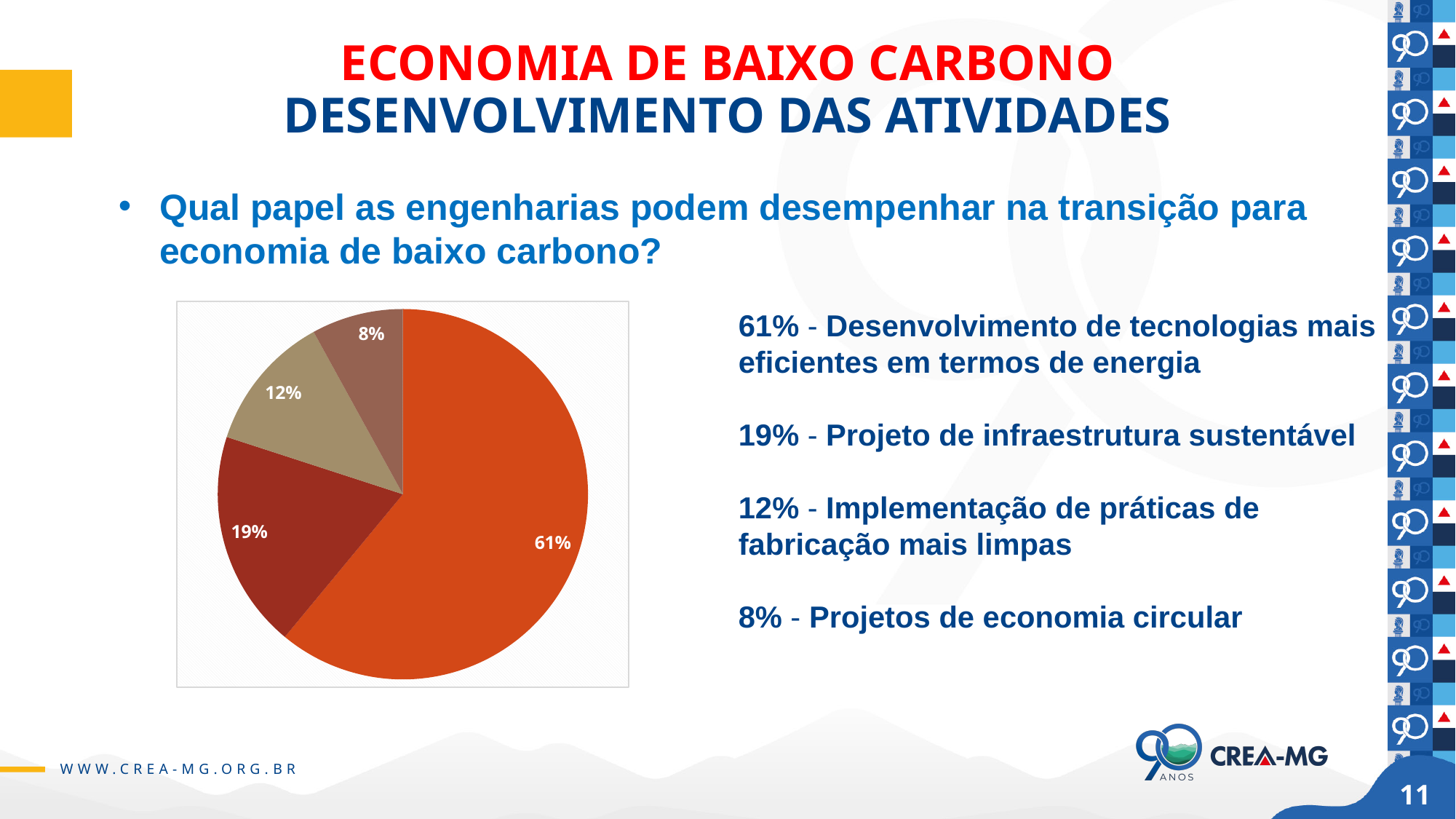
What colour is the largest slice of the pie chart? orange-red What share of the pie corresponds to 'Projetos de economia circular'? 8% What is the combined share of the two smallest slices (12% and 8%)? 20% What share of the pie corresponds to 'Projeto de infraestrutura sustentável'? 19% What is the difference between the largest slice (61%) and the slice for 'Projeto de infraestrutura sustentável' (19%)? 42% What share of the pie corresponds to 'Desenvolvimento de tecnologias mais eficientes em termos de energia'? 61% What kind of chart is shown on the slide? pie chart Which category has the largest slice of the pie? Desenvolvimento de tecnologias mais eficientes em termos de energia Which is larger: the slice for 'Implementação de práticas de fabricação mais limpas' or the slice for 'Projetos de economia circular'? Implementação de práticas de fabricação mais limpas Which category has the smallest slice of the pie? Projetos de economia circular How many slices does the pie chart have? 4